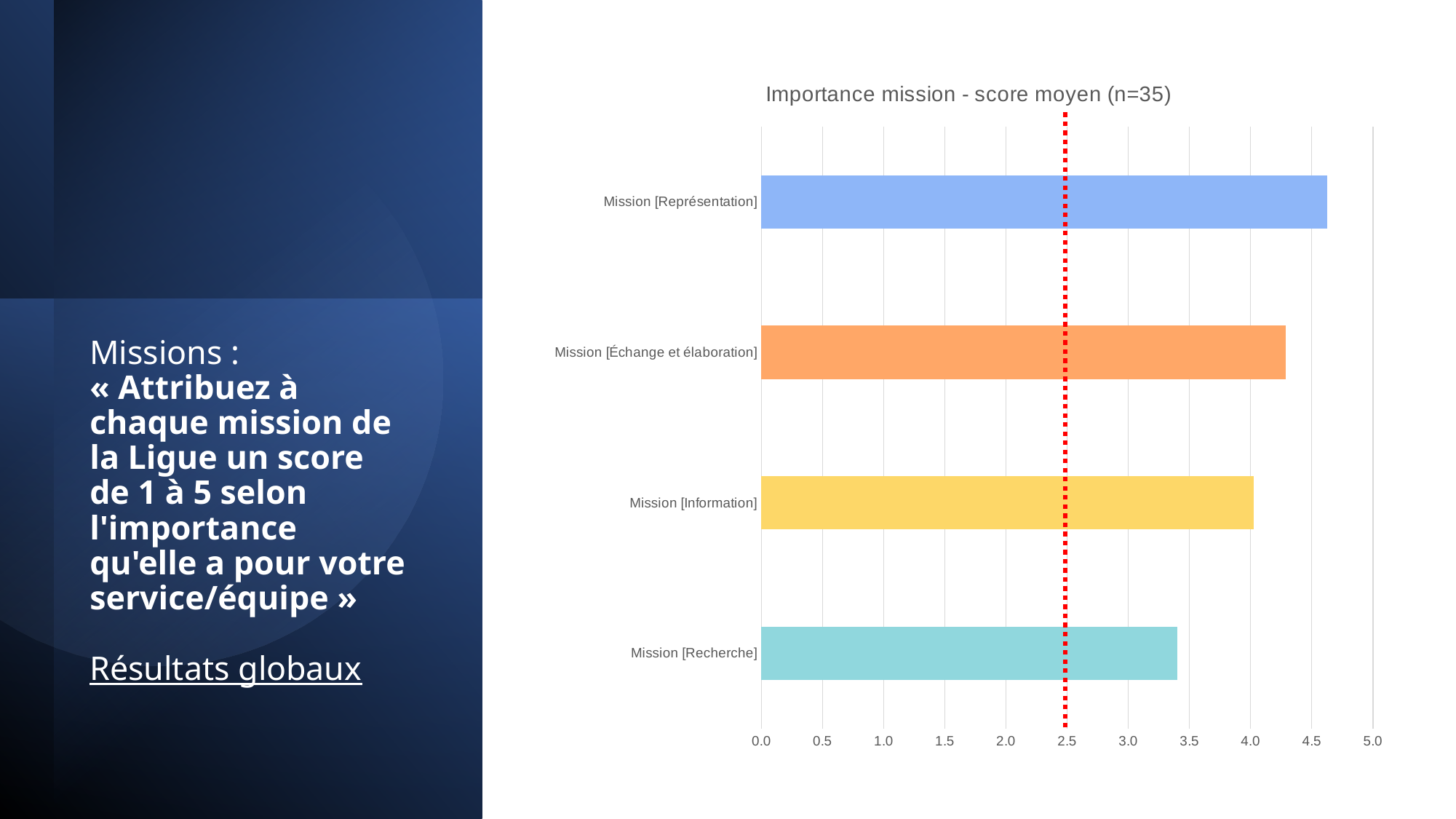
Which mission has the lowest average importance score? Mission [Recherche] Is the value for Mission [Information] greater or less than 3.5? greater Which has a higher score, Mission [Échange et élaboration] or Mission [Information]? Mission [Échange et élaboration] Which has a higher score, Mission [Représentation] or Mission [Recherche]? Mission [Représentation] Is the value for Mission [Représentation] greater or less than 4.0? greater How many missions (categories) are plotted in the chart? 4 At what value on the x axis is the red dotted vertical line drawn? 2.5 Is the value for Mission [Recherche] greater or less than 4.0? less Which mission has the highest average importance score? Mission [Représentation] What kind of chart is shown on the slide? bar chart What is the title of the chart? Importance mission - score moyen (n=35)